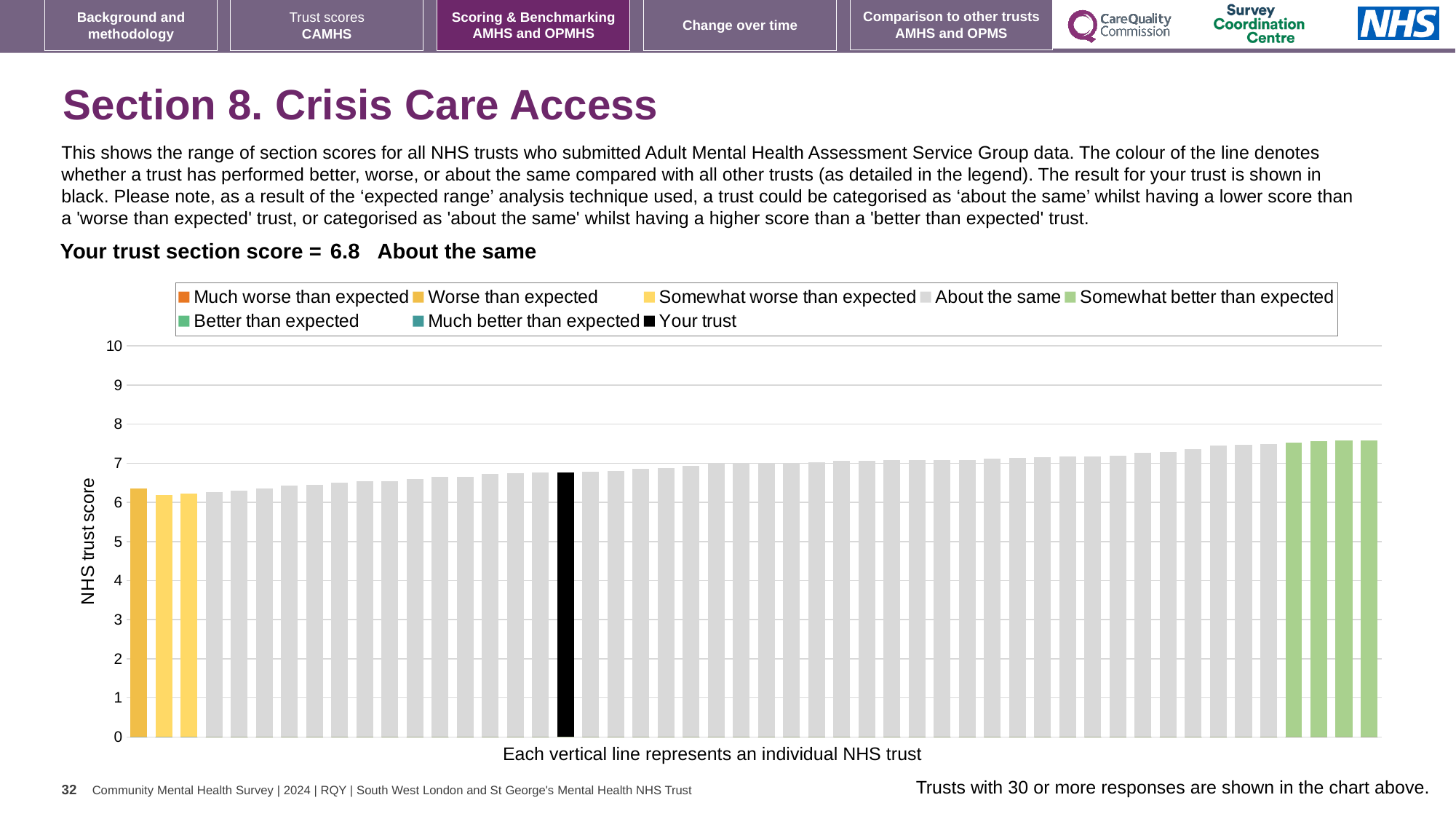
What kind of chart is shown on the slide? bar chart What is the section score for your trust? 6.8 Is the black 'Your trust' bar higher or lower than the rightmost green bar? lower How many bars are coloured green (somewhat better than expected)? 4 Do the bar values rise or fall from left to right across the chart? rise How many entries does the chart legend list? 8 Which benchmarking category is your trust placed in for this section? About the same Is the value of the leftmost bar greater or less than 6? greater Is the value of the tallest bar in the chart greater or less than 7? greater Is the value of the black 'Your trust' bar greater or less than 6? greater What is the label on the vertical axis of the chart? NHS trust score